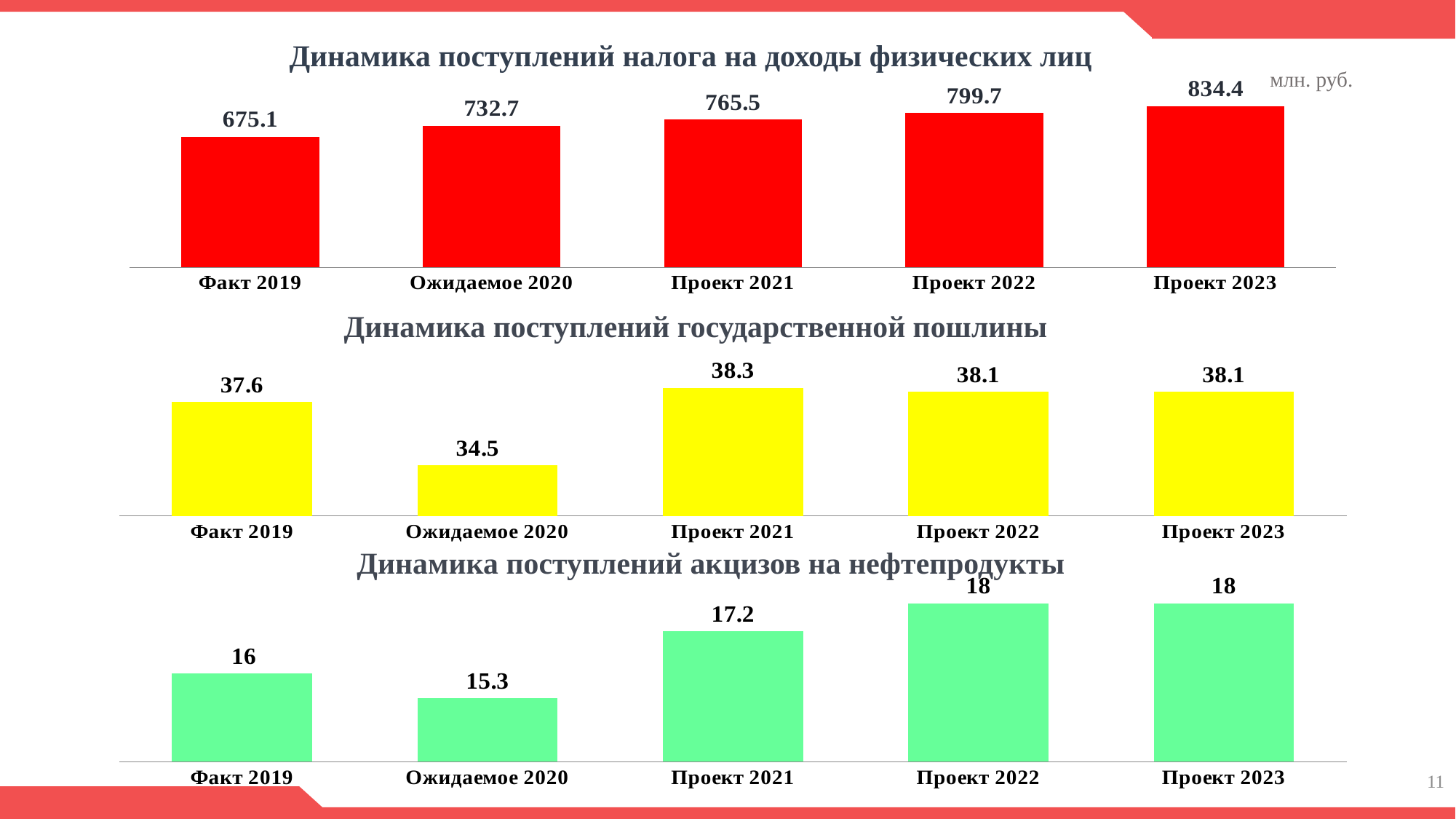
In the chart 'Динамика поступлений налога на доходы физических лиц', do the values rise or fall from Факт 2019 to Проект 2023? rise In the chart 'Динамика поступлений акцизов на нефтепродукты', which category has the lowest value? Ожидаемое 2020 How many categories are shown in the chart 'Динамика поступлений акцизов на нефтепродукты'? 5 In the chart 'Динамика поступлений налога на доходы физических лиц', what is the value for Проект 2023? 834.4 In the chart 'Динамика поступлений акцизов на нефтепродукты', which is larger, Факт 2019 or Ожидаемое 2020? Факт 2019 In the chart 'Динамика поступлений налога на доходы физических лиц', which category has the lowest value? Факт 2019 In the chart 'Динамика поступлений акцизов на нефтепродукты', what is the value for Проект 2021? 17.2 In the chart 'Динамика поступлений государственной пошлины', what is the difference between Проект 2021 and Ожидаемое 2020? 3.8 In the chart 'Динамика поступлений государственной пошлины', which category has the highest value? Проект 2021 What type of chart is 'Динамика поступлений государственной пошлины'? bar chart In the chart 'Динамика поступлений налога на доходы физических лиц', what is the difference between Проект 2023 and Факт 2019? 159.3 In the chart 'Динамика поступлений государственной пошлины', what is the value for Ожидаемое 2020? 34.5